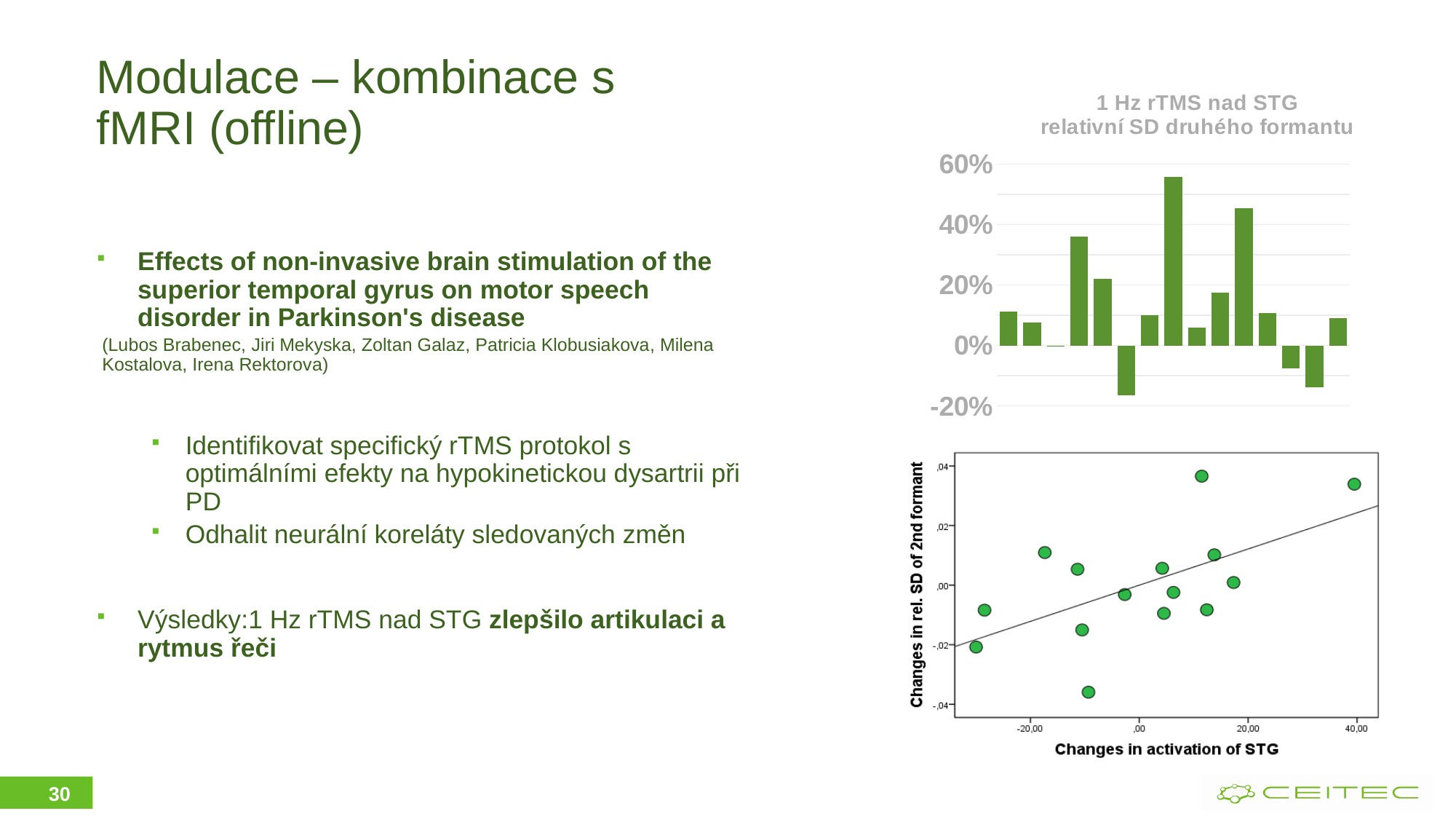
In the lower scatter plot, do the points generally rise or fall as "Changes in activation of STG" increases? rise In the bar chart "1 Hz rTMS nad STG relativní SD druhého formantu", what is the highest value shown on the vertical axis? 60% In the bar chart "1 Hz rTMS nad STG relativní SD druhého formantu", is the value of the lowest bar greater or less than -20%? greater How many data points are plotted in the lower scatter plot? 15 What is the label of the vertical axis of the lower scatter plot? Changes in rel. SD of 2nd formant In the bar chart "1 Hz rTMS nad STG relativní SD druhého formantu", is the value of the lowest bar greater or less than -10%? less In the bar chart "1 Hz rTMS nad STG relativní SD druhého formantu", is the value of the tallest bar greater or less than 40%? greater What kind of chart is the lower chart with the axis "Changes in activation of STG"? scatter plot What kind of chart is the chart titled "1 Hz rTMS nad STG relativní SD druhého formantu"? bar chart